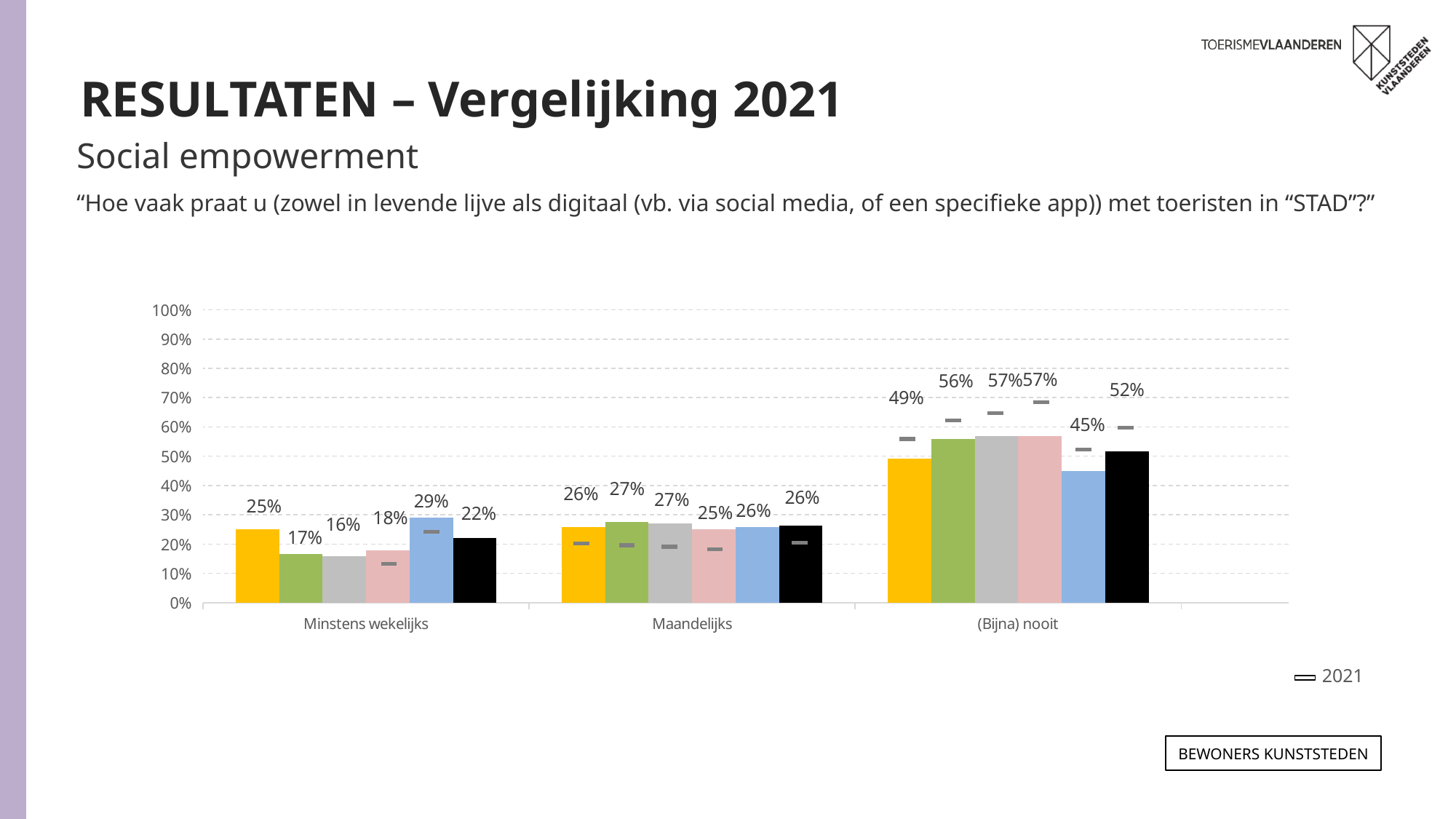
What kind of chart is shown on the slide? bar chart What entry does the chart legend list? 2021 What is the value of the yellow bar for "(Bijna) nooit"? 49% What is the value of the blue bar for "Minstens wekelijks"? 29% For the black bar, which is larger: the value for "(Bijna) nooit" or the value for "Maandelijks"? (Bijna) nooit How many categories are shown on the x axis of the chart? 3 What is the value of the black bar for "(Bijna) nooit"? 52% Is the value of the green bar for "(Bijna) nooit" greater or less than 50%? greater What is the value of the yellow bar for "Minstens wekelijks"? 25% Which coloured bar is the highest in the "Minstens wekelijks" category? the blue bar (29%) What is the difference between the blue bar (29%) and the grey bar (16%) for "Minstens wekelijks"? 13 percentage points Which coloured bar is the lowest in the "(Bijna) nooit" category? the blue bar (45%)